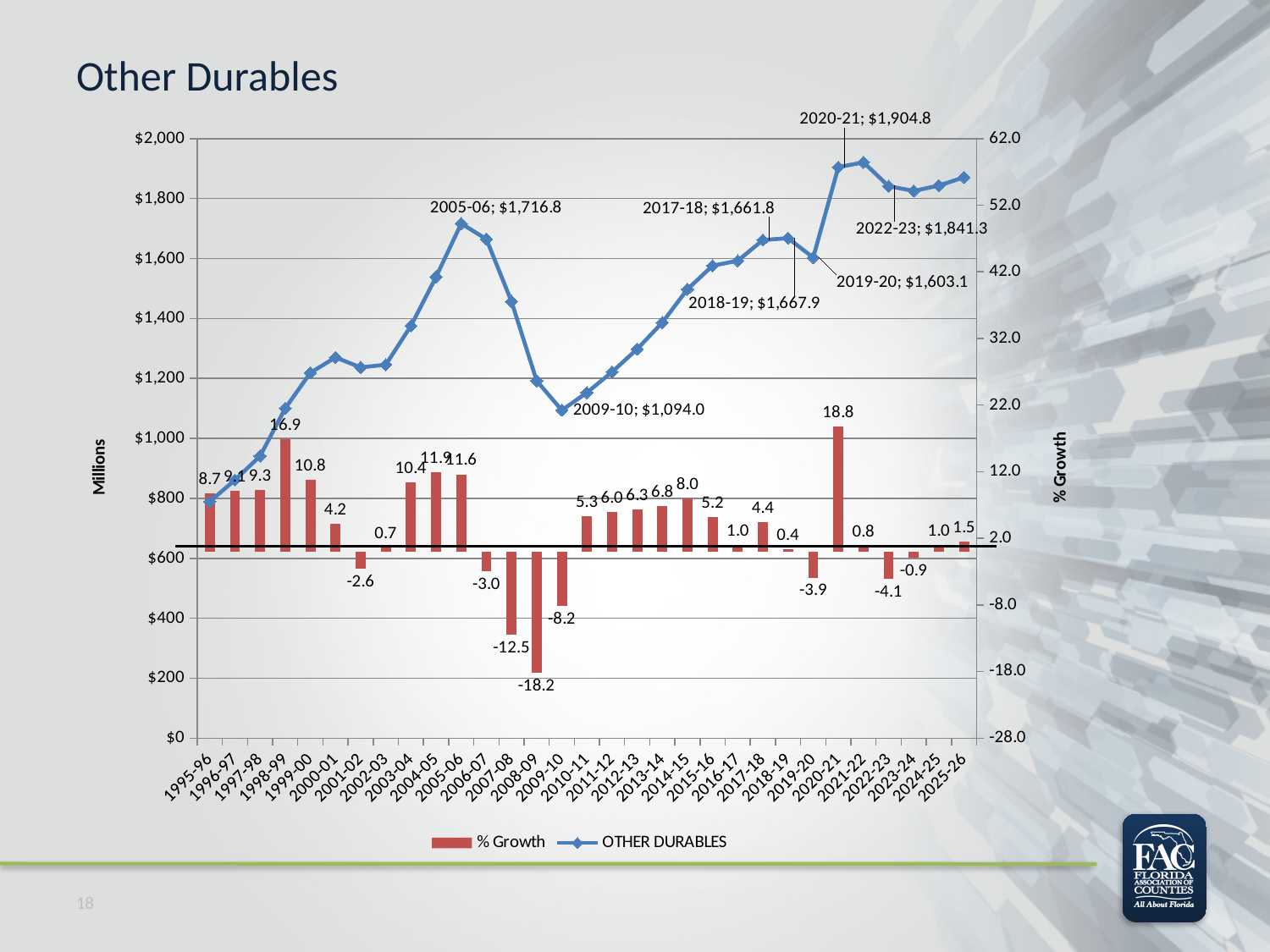
What is the % Growth value for 2020-21? 18.8 What kind of chart is used for the OTHER DURABLES series? Line chart Which year has the lowest % Growth bar? 2008-09 Is the OTHER DURABLES value for 2025-26 greater or less than $1,800? greater What is the OTHER DURABLES value labeled for 2009-10? $1,094.0 How many fiscal years are shown on the x axis? 31 What is the % Growth value for 2008-09? -18.2 How many series does the legend list? 2 What is the difference between the OTHER DURABLES values for 2020-21 and 2019-20? $301.7 What is the title of the slide? Other Durables Which year has the highest % Growth bar? 2020-21 Which is larger, the OTHER DURABLES value for 2005-06 or for 2017-18? 2005-06